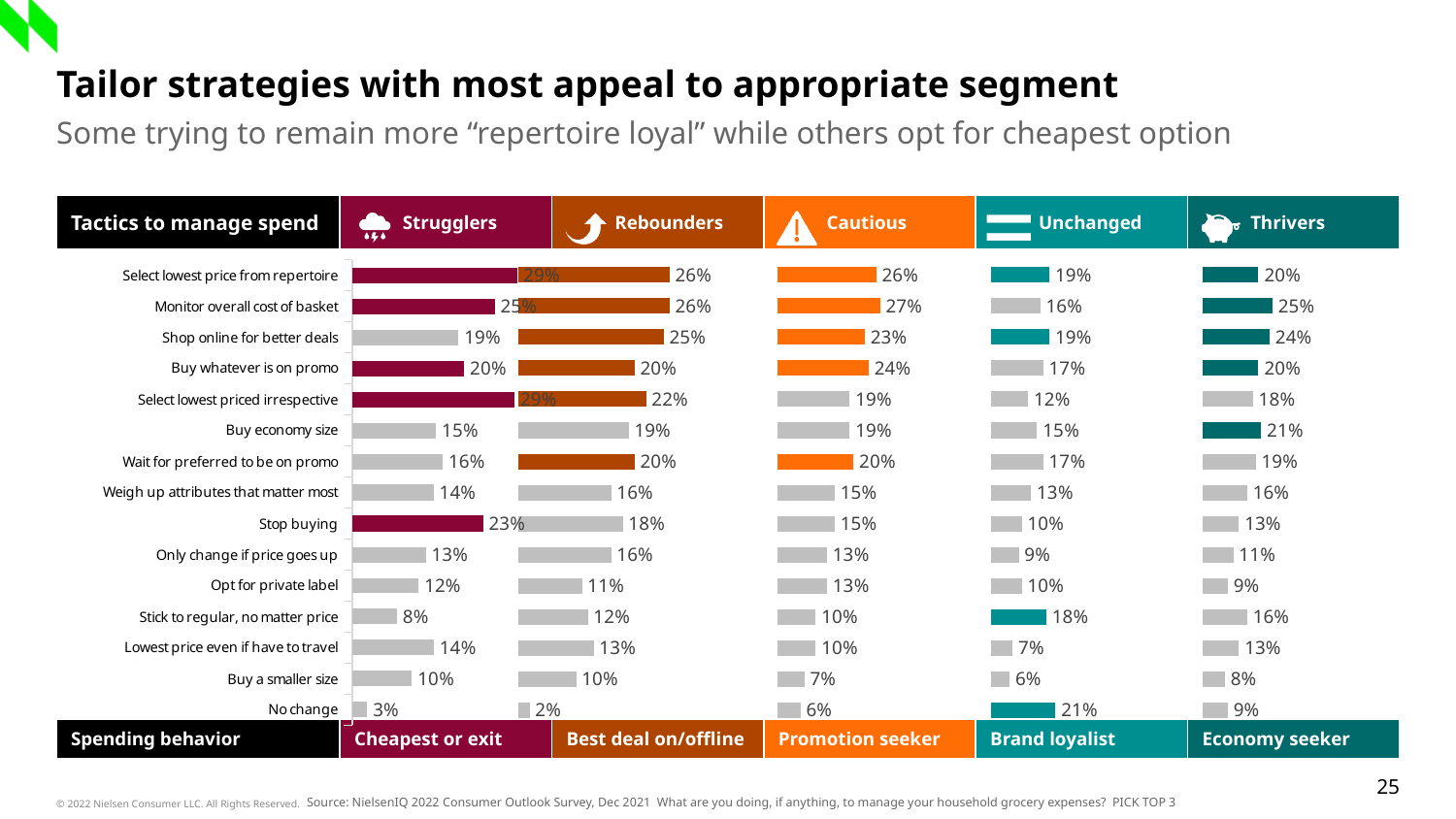
In the Cautious chart, what is the value for "Monitor overall cost of basket"? 27% In the Unchanged chart, what is the value for "No change"? 21% In the Strugglers chart, what is the value for "Stop buying"? 23% In the Cautious chart, which tactic has the highest value? Monitor overall cost of basket What type of chart is used for each segment on the slide? Bar chart In the Rebounders chart, what is the value for "Shop online for better deals"? 25% How many tactics are listed in each chart? 15 In the Strugglers chart, what is the difference between "Select lowest price from repertoire" and "Monitor overall cost of basket"? 4% In the Rebounders chart, which tactic has the lowest value? No change In the Unchanged chart, which is larger: "Stick to regular, no matter price" or "Buy whatever is on promo"? Stick to regular, no matter price In the Thrivers chart, which tactic has the highest value? Monitor overall cost of basket In the Thrivers chart, what is the value for "Buy economy size"? 21%